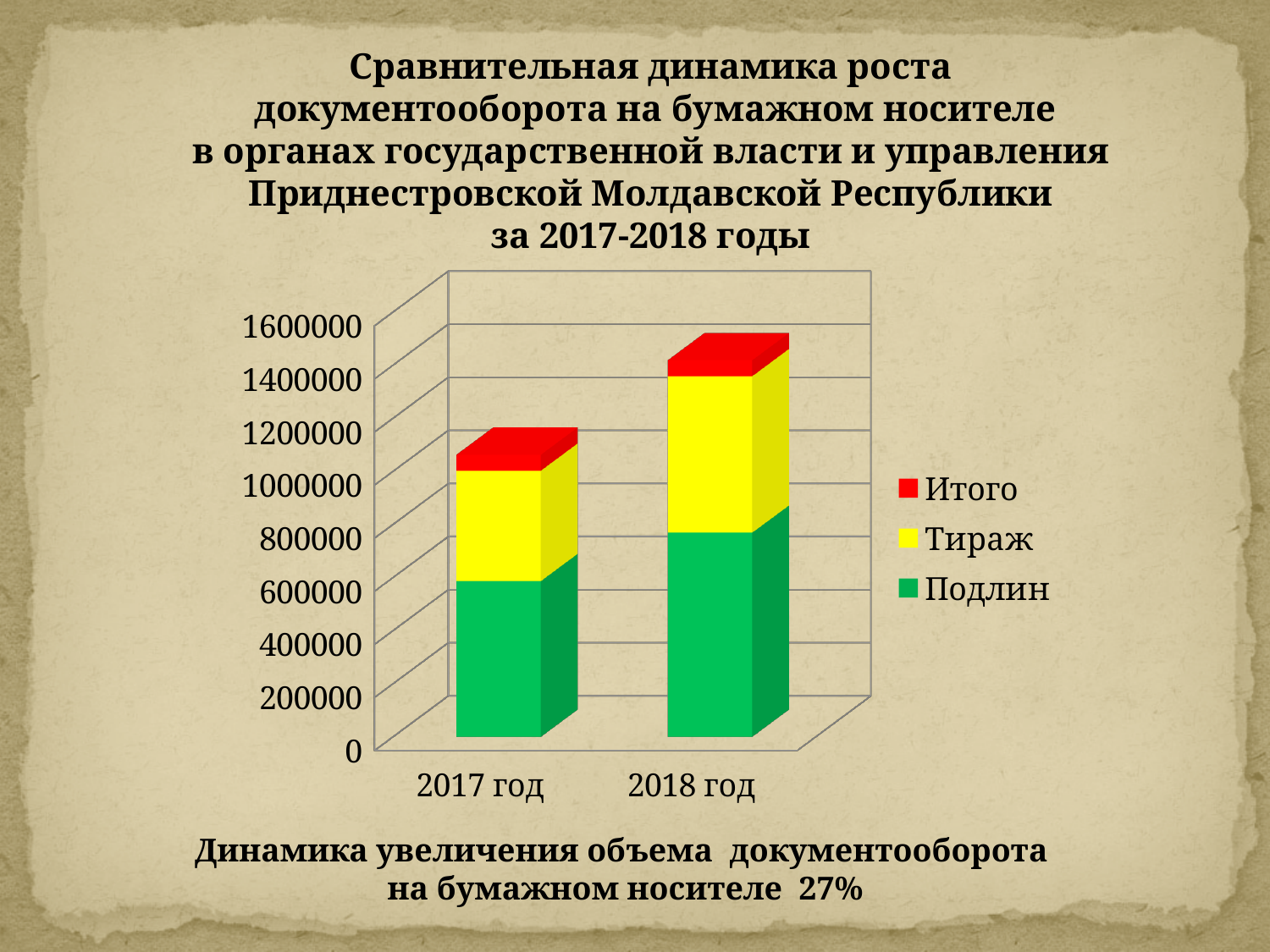
What is the highest value shown on the vertical axis of the chart? 1600000 Is the total height of the stacked bar for 2018 год greater or less than 1600000? less Is the total height of the stacked bar for 2017 год greater or less than 1200000? less What kind of chart is shown on the slide? stacked bar chart Does the total height of the stacked bars rise or fall from 2017 год to 2018 год? rise Is the total height of the stacked bar for 2018 год greater or less than 1200000? greater How many categories (years) are shown on the x axis of the chart? 2 Which series is shown in green in the chart? Подлин Is the Подлин segment larger for 2017 год or for 2018 год? 2018 год How many series does the chart legend list? 3 Which series is shown in red in the chart? Итого Which year has the taller stacked bar, 2017 год or 2018 год? 2018 год